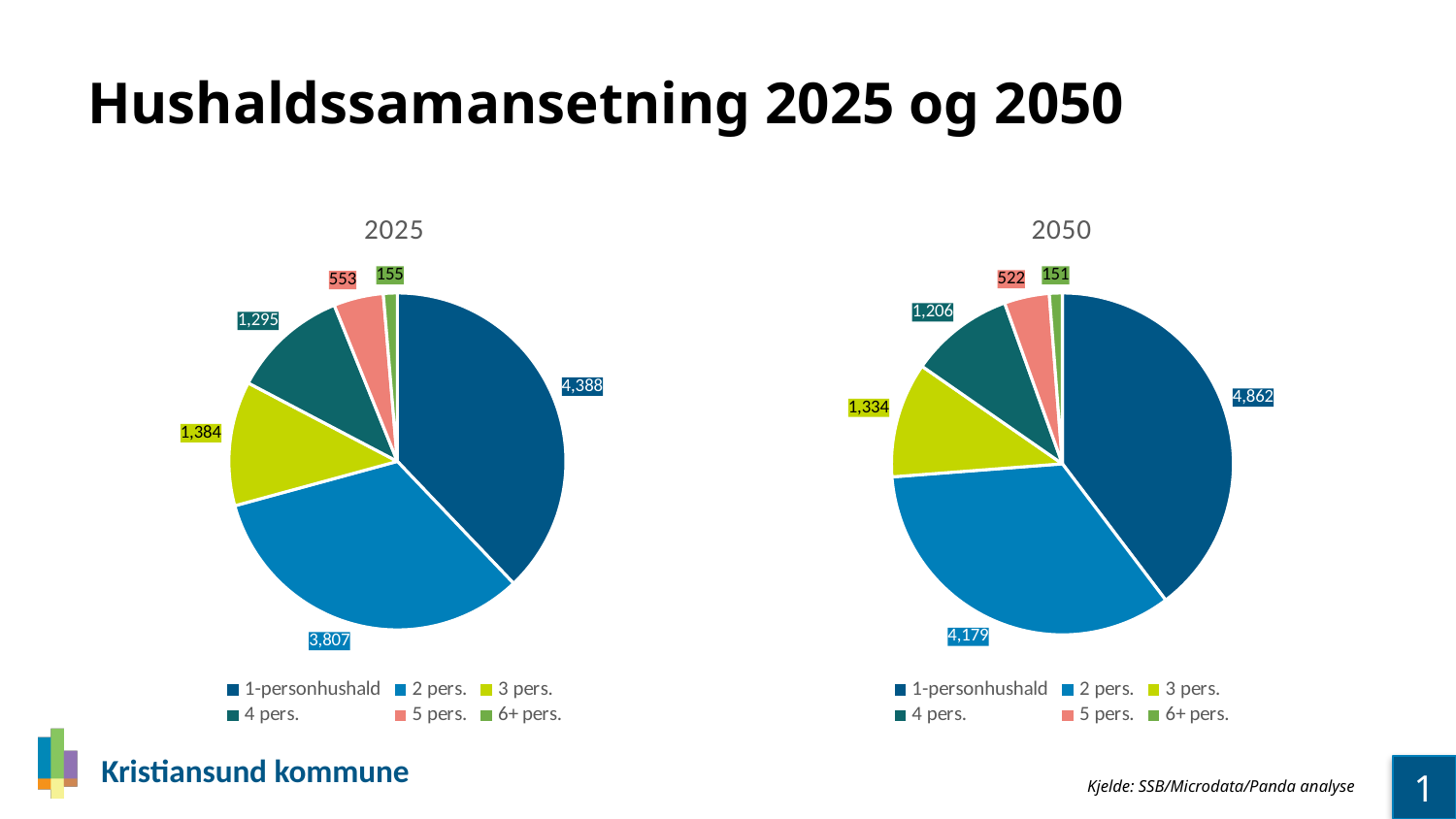
In the 2050 pie chart, which category has the largest value? 1-personhushald In the 2025 pie chart, what is the value for 1-personhushald? 4,388 In the 2050 pie chart, which is larger: 3 pers. or 4 pers.? 3 pers. What type of chart is used for the 2050 data? Pie chart How many categories does the 2025 pie chart show? 6 In the 2050 pie chart, what is the value for 2 pers.? 4,179 What is the title of the chart on the left? 2025 In the 2025 pie chart, which category has the smallest value? 6+ pers. In the 2050 pie chart, what is the value for 6+ pers.? 151 In the 2025 pie chart, what is the value for 4 pers.? 1,295 What is the difference between the 1-personhushald value in the 2050 chart and in the 2025 chart? 474 In the 2025 pie chart, what is the difference between the values for 2 pers. and 3 pers.? 2,423